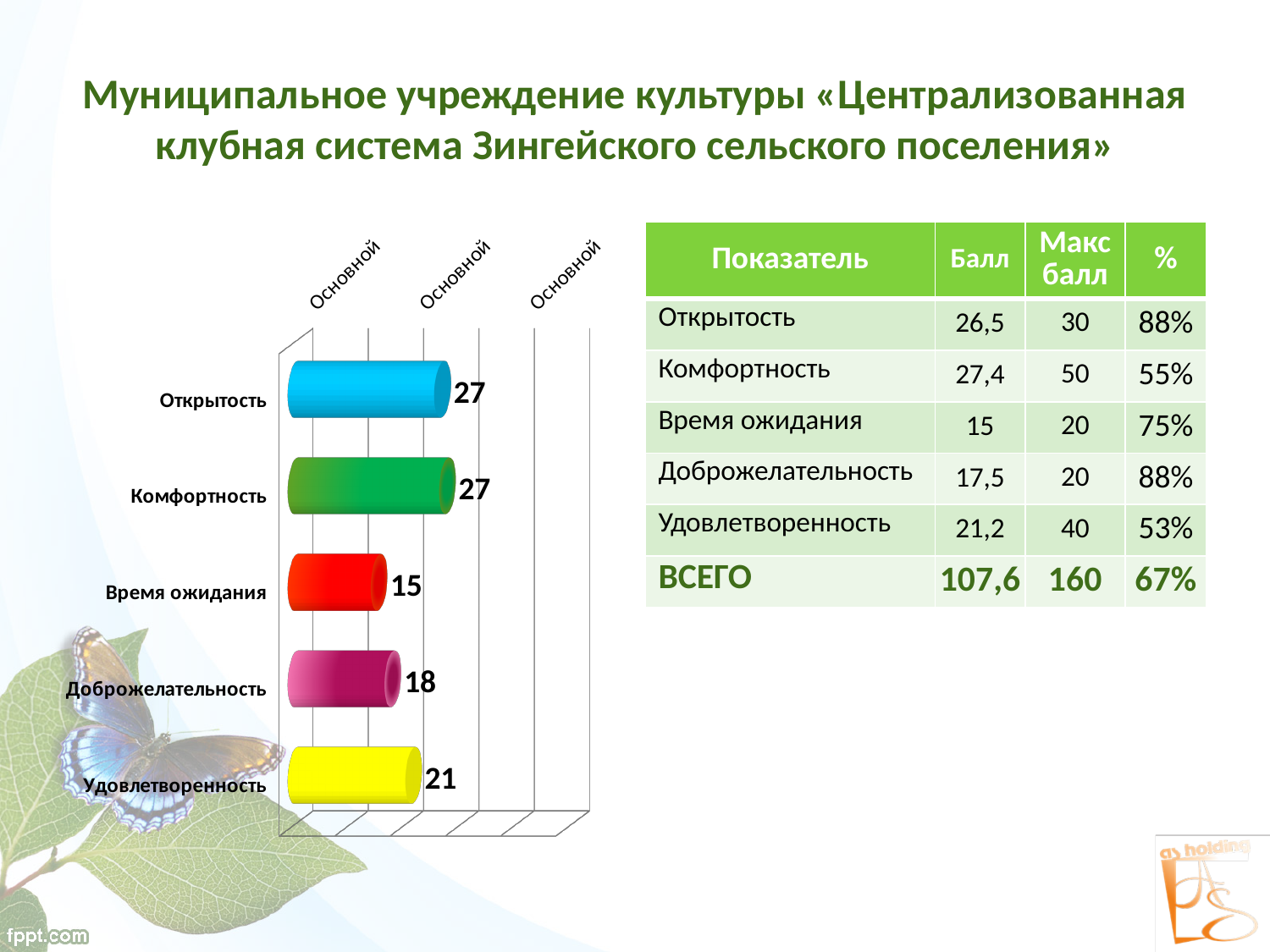
What is the difference between the values for Удовлетворенность and Время ожидания in the bar chart? 6 Which category has the lowest value in the bar chart? Время ожидания How many categories are shown in the bar chart? 5 In the bar chart, which is larger: the value for Удовлетворенность or the value for Доброжелательность? Удовлетворенность In the bar chart, which is larger: the value for Время ожидания or the value for Открытость? Открытость What colour is the bar for Время ожидания in the chart? Red What value is shown for Удовлетворенность in the bar chart? 21 What value is shown for Доброжелательность in the bar chart? 18 What type of chart is shown on the slide? Bar chart What value is shown for Открытость in the bar chart? 27 What is the difference between the values for Комфортность and Доброжелательность in the bar chart? 9 What value is shown for Время ожидания in the bar chart? 15